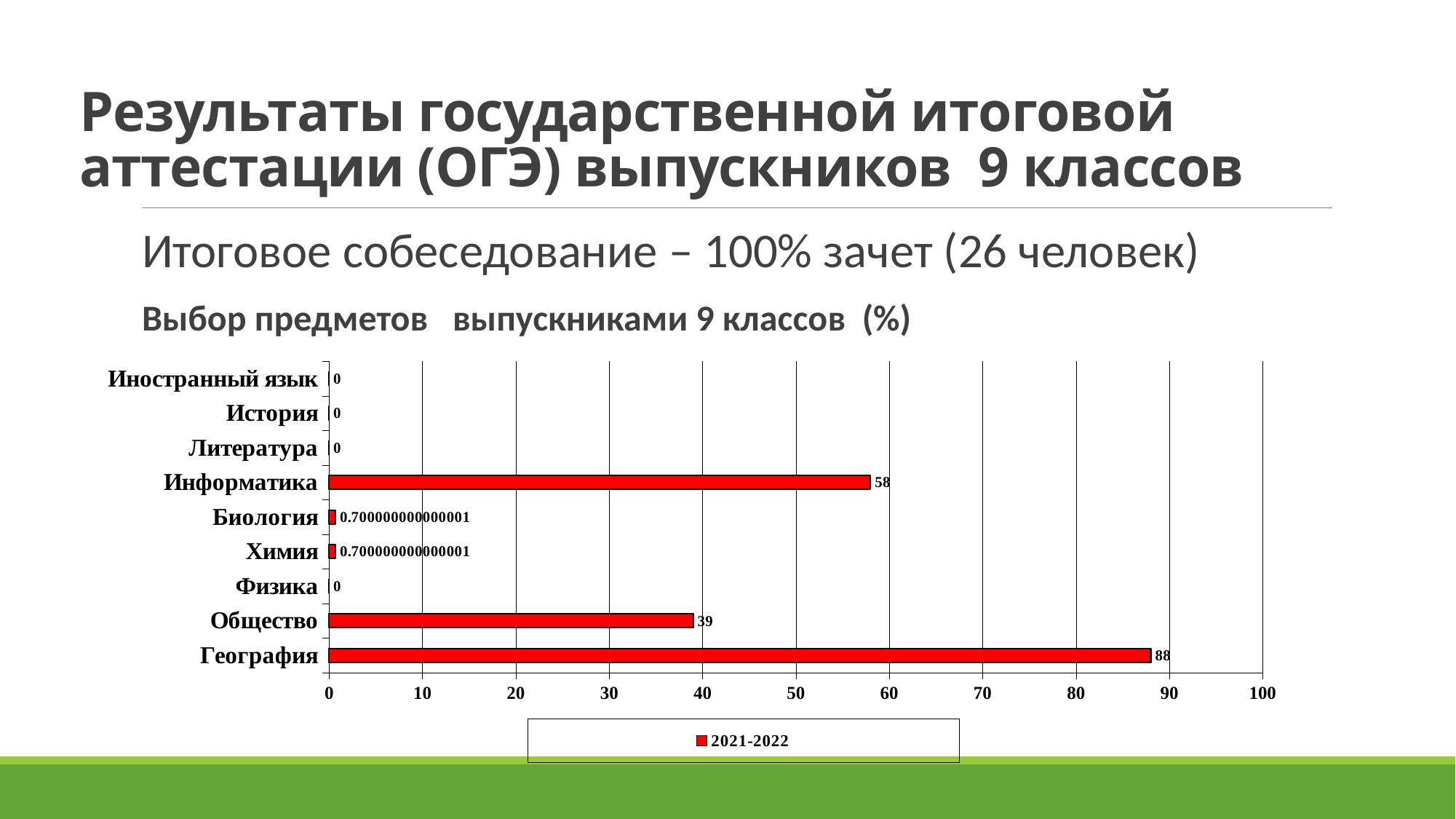
What is the value for Общество? 39 How many series does the legend list? 1 What is the value for География? 88 How many subjects (categories) are shown on the chart? 9 What is the value for Информатика? 58 Which subject has the highest value? География What type of chart is shown on the slide? bar chart Which is larger, the value for Общество or the value for Информатика? Информатика What is the difference between the values for География and Информатика? 30 What series name is shown in the legend? 2021-2022 What is the value for Физика? 0 What is the difference between the values for Информатика and Общество? 19